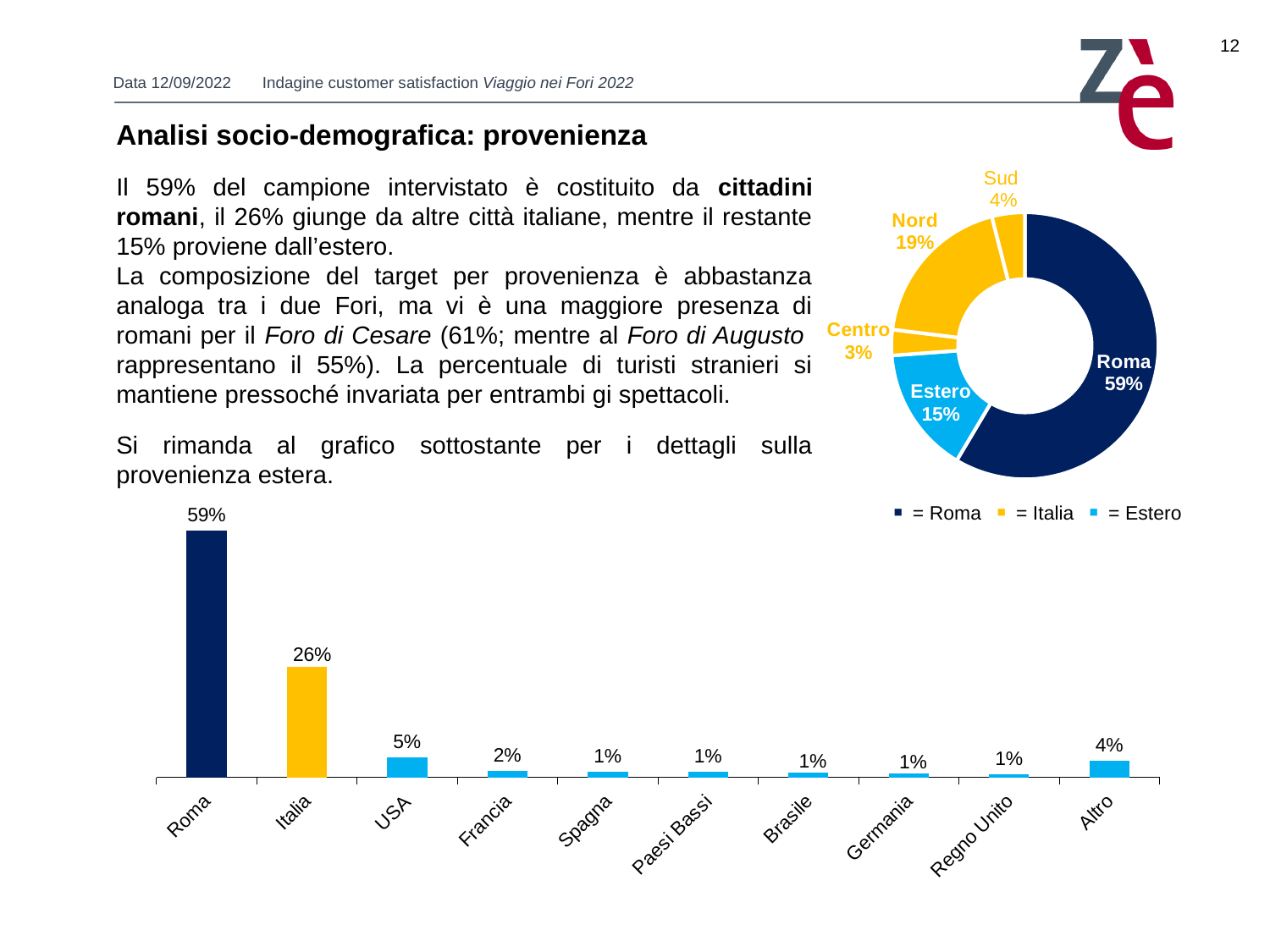
In the donut chart at the top right of the slide, what is the value for Nord? 19% How many categories are shown in the bar chart at the bottom of the slide? 10 In the bar chart at the bottom of the slide, what is the value for USA? 5% In the donut chart at the top right of the slide, what is the value for Centro? 3% What kind of chart is the chart at the bottom of the slide? bar chart In the donut chart at the top right of the slide, which segment has the smallest value? Centro How many entries does the legend of the donut chart at the top right of the slide list? 3 In the bar chart at the bottom of the slide, what is the value for Altro? 4% In the bar chart at the bottom of the slide, what is the difference between the values for Roma and Italia? 33% In the bar chart at the bottom of the slide, what is the value for Roma? 59% In the bar chart at the bottom of the slide, which category has the highest value? Roma In the bar chart at the bottom of the slide, which is larger, the value for USA or the value for Francia? USA